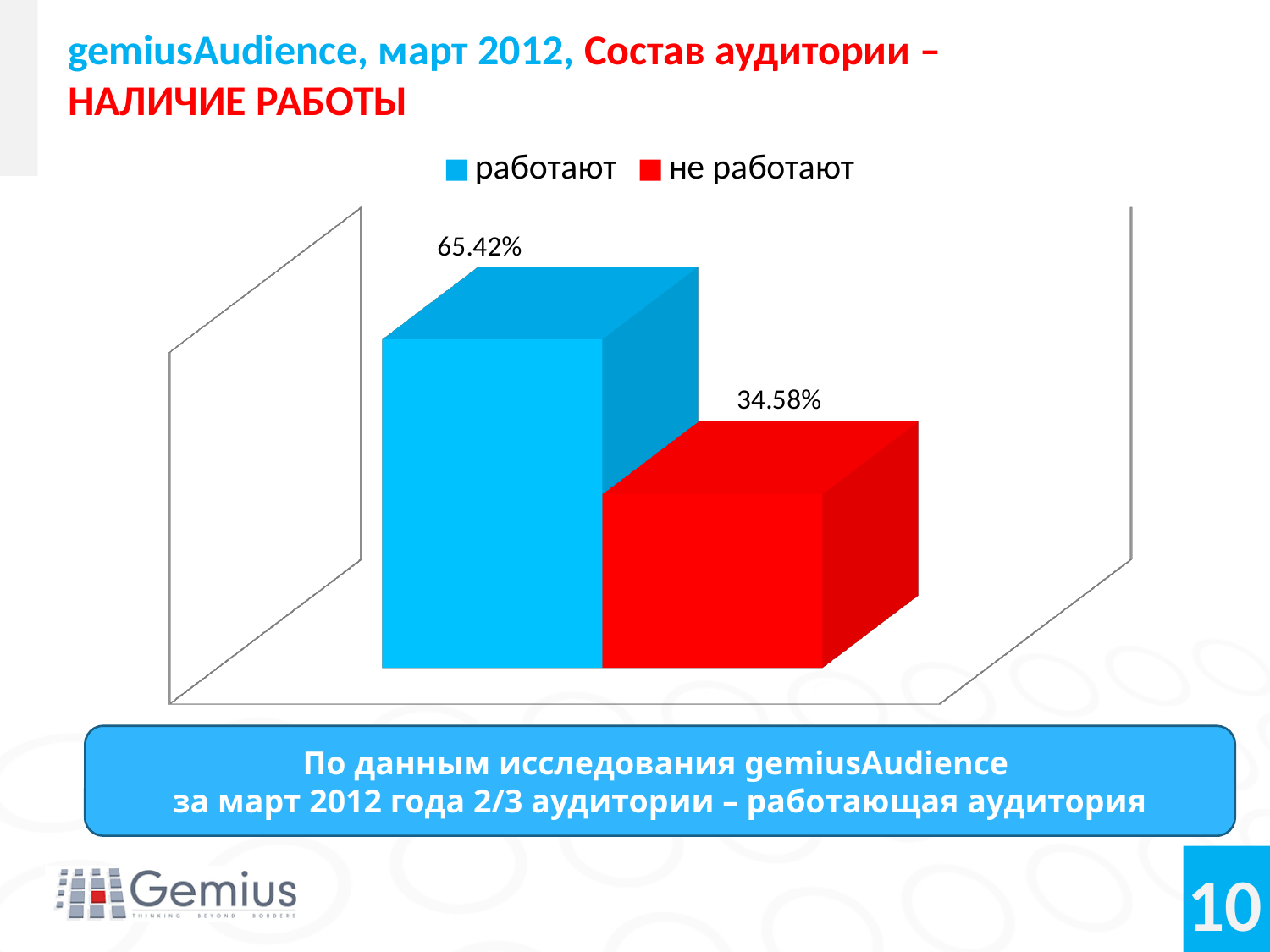
What is the difference between the values for "работают" and "не работают"? 30.84% What kind of chart is shown on the slide? bar chart Which series has the lowest value? не работают What colour is the bar for "не работают"? red What is the value for "не работают"? 34.58% What is the value for "работают"? 65.42% What colour is the bar for "работают"? blue How many bars are plotted on the chart? 2 What is the total of the two plotted values? 100% Which is larger, the value for "работают" or for "не работают"? работают How many series does the legend list? 2 Which series has the highest value? работают